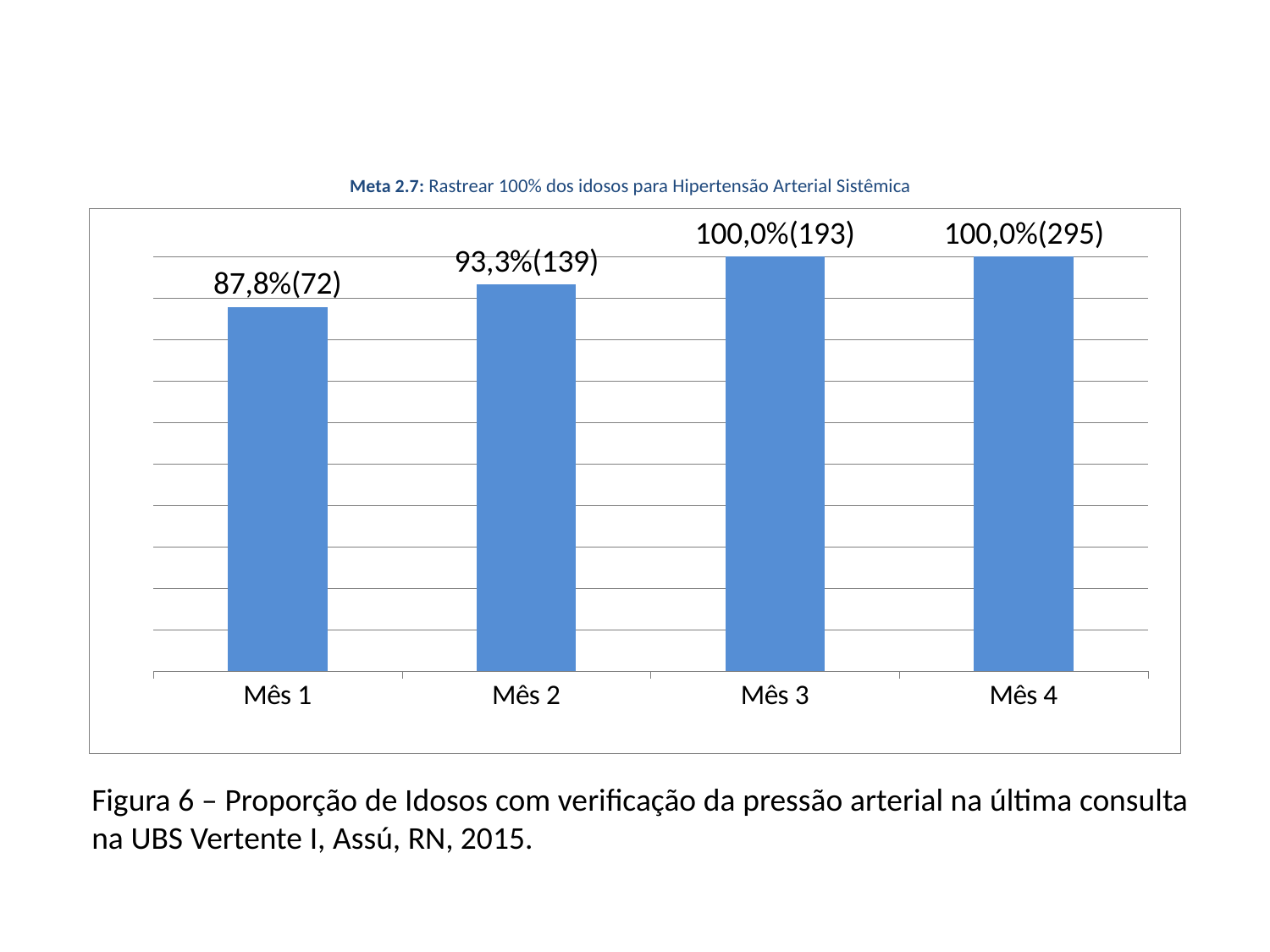
How many months are shown on the x axis? 4 What is the highest percentage shown on the chart? 100,0% What is the data label shown for Mês 1? 87,8%(72) What is the difference in percentage points between Mês 2 and Mês 1? 5,5 Which month has the lowest percentage? Mês 1 What is the data label shown for Mês 3? 100,0%(193) What is the data label shown for Mês 2? 93,3%(139) Which has the larger percentage, Mês 1 or Mês 2? Mês 2 What is the figure number given in the caption below the chart? Figura 6 Do the percentages rise or fall from Mês 1 to Mês 4? Rise What kind of chart is shown on the slide? Bar chart What is the data label shown for Mês 4? 100,0%(295)